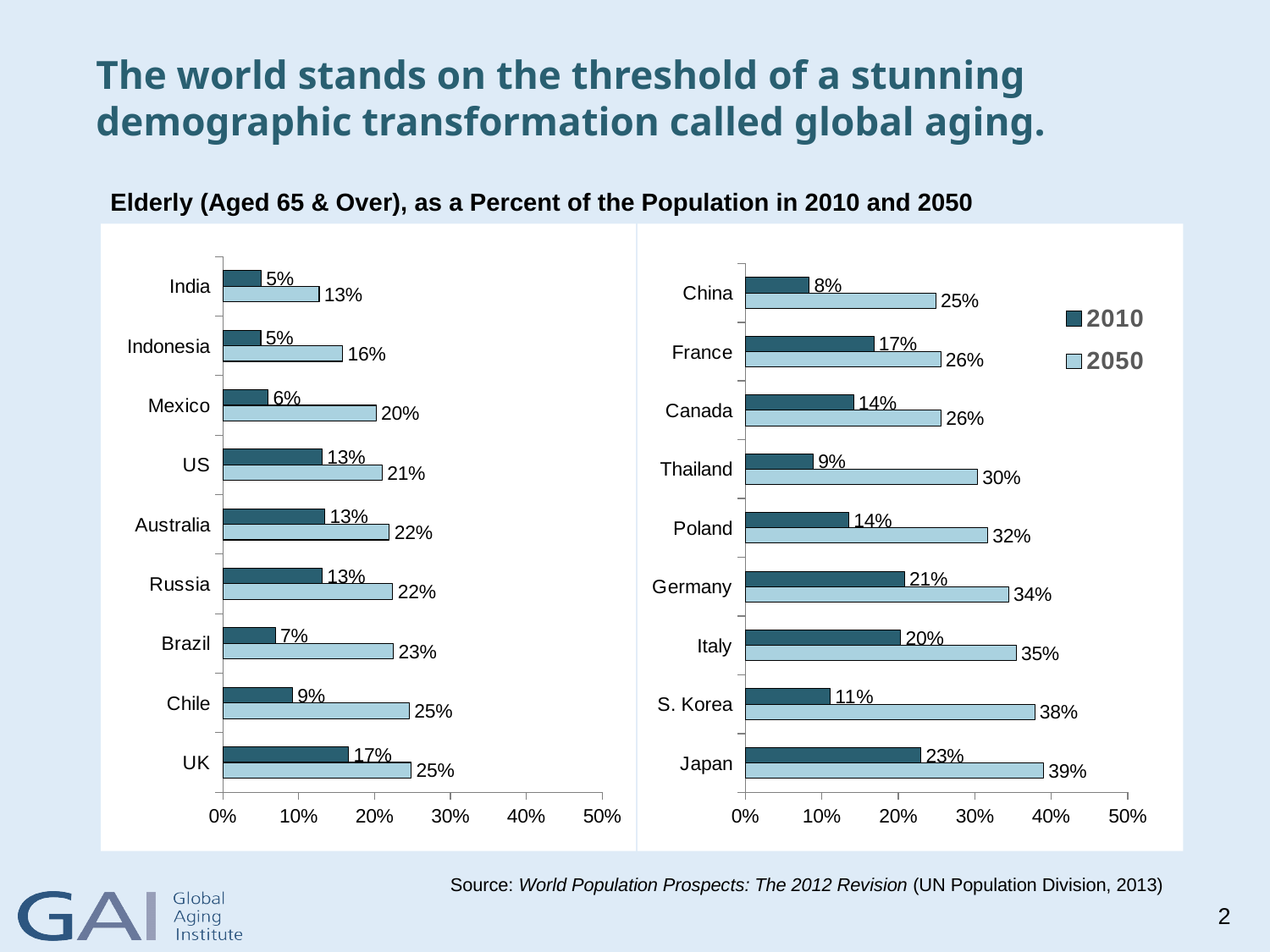
How many countries are shown in the left chart? 9 In the right chart, which country has the highest 2050 value? Japan In the left chart, which country has the lowest 2050 value? India In the left chart, which is larger: the 2050 value for Brazil or the 2050 value for US? Brazil In the right chart, what is the 2010 value for Japan? 23% In the right chart, what is the 2010 value for Germany? 21% What are the two series named in the legend? 2010 and 2050 In the right chart, what is the difference between the 2050 and 2010 values for S. Korea? 27% What type of chart is used on this slide? Bar chart In the left chart, what is the 2050 value for Mexico? 20% How many series does the legend list? 2 In the right chart, is the 2050 value for Thailand greater or less than 20%? greater